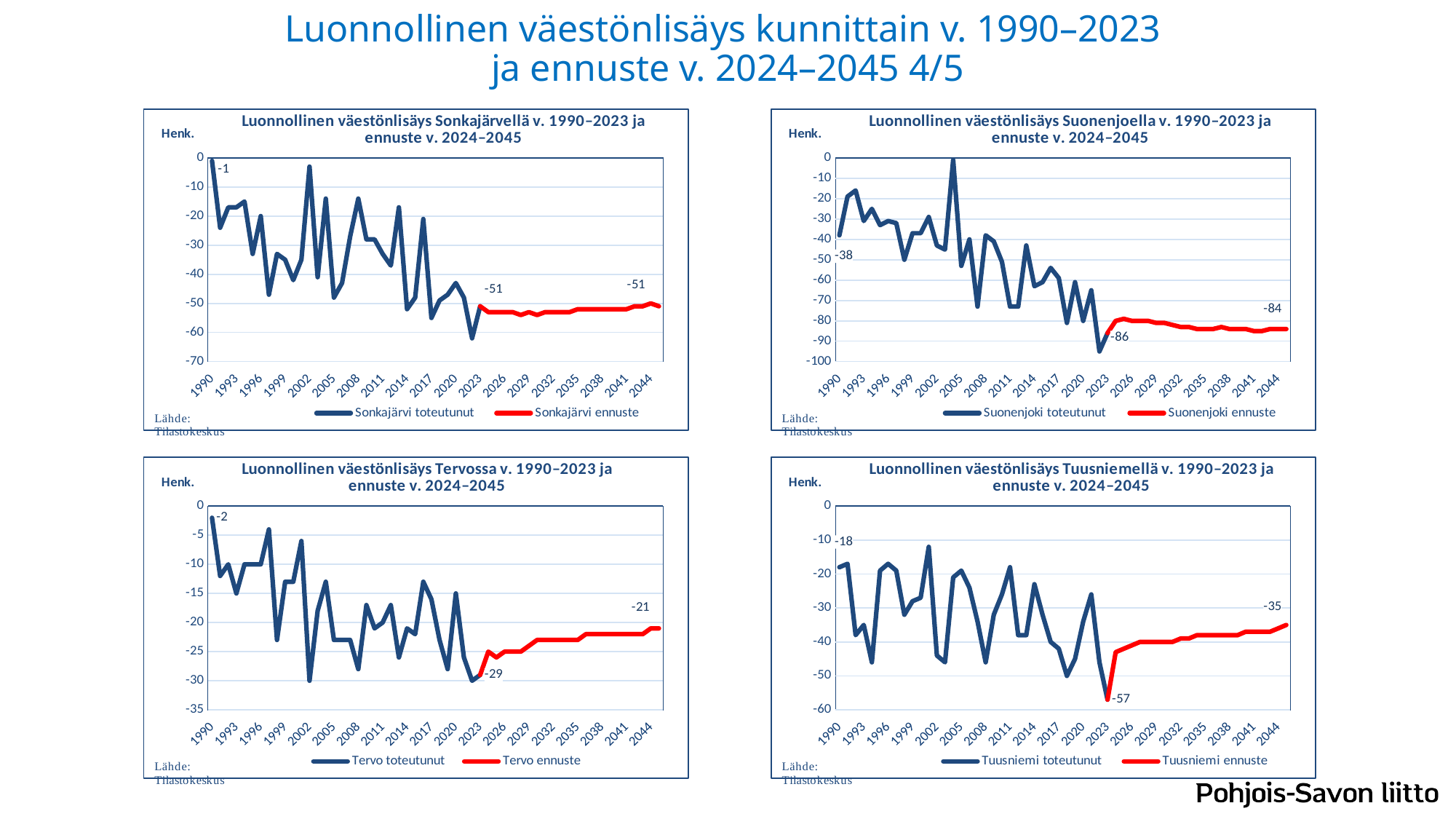
In the Sonkajärvi chart (top left), what colour is the forecast (ennuste) line? red How many series does the legend of the Tervo chart (bottom left) list? 2 In the Suonenjoki chart (top right), what value is labelled for 2045? -84 In the Suonenjoki chart (top right), what value is labelled for 2023? -86 In the Sonkajärvi chart (top left), what value is labelled for 1990? -1 What type of chart is the Tuusniemi chart (bottom right)? line chart In the Sonkajärvi chart (top left), what value is labelled at the end of the forecast in 2045? -51 In the Tuusniemi chart (bottom right), what value is labelled for 1990? -18 In the Tuusniemi chart (bottom right), what is the difference between the 1990 value (-18) and the 2023 value (-57)? 39 In the Tervo chart (bottom left), which is larger, the labelled value for 1990 or the labelled value for 2045? 1990 (-2) In the Tervo chart (bottom left), what value is labelled for 2023? -29